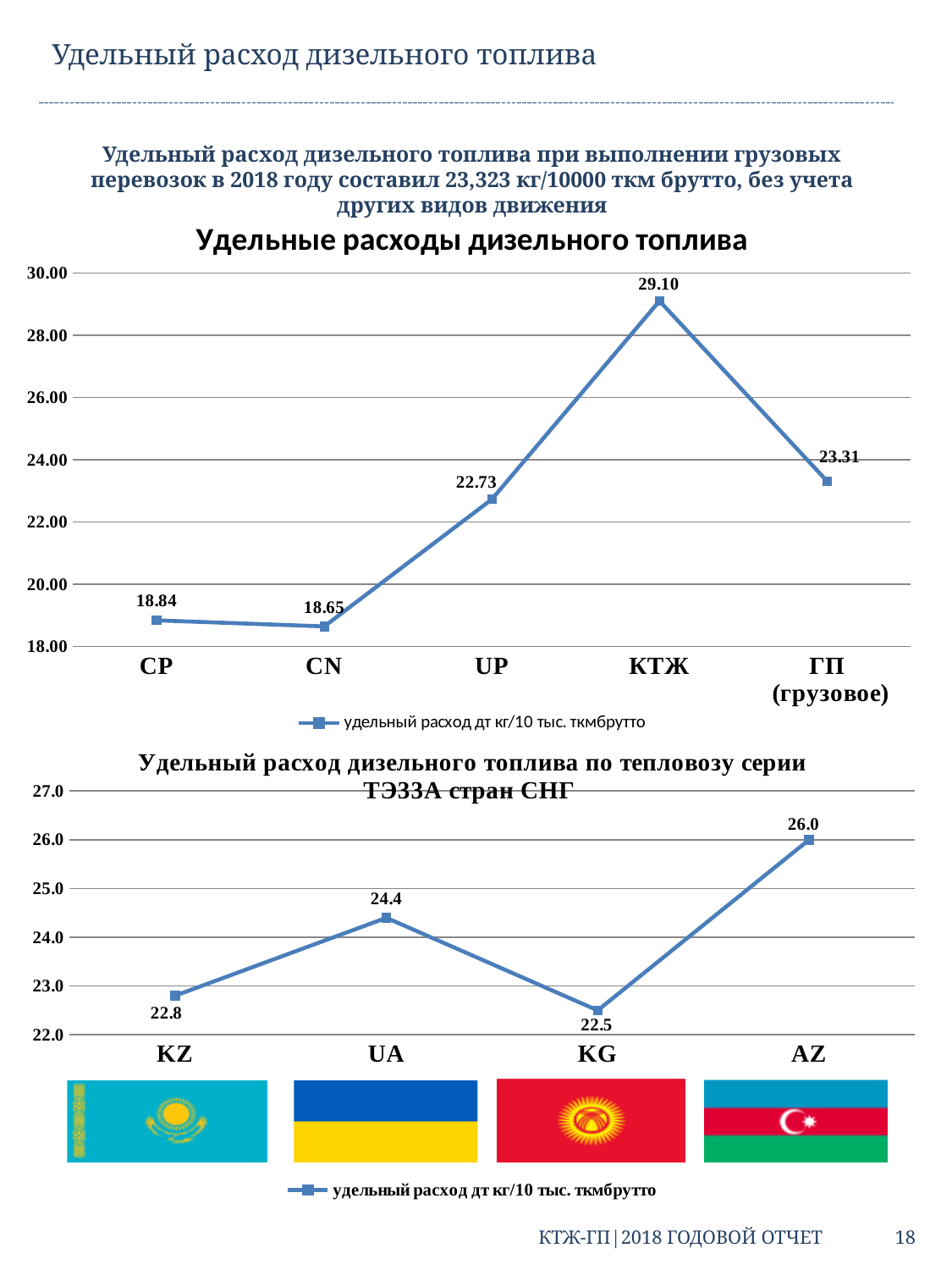
In the top chart 'Удельные расходы дизельного топлива', which category has the highest value? КТЖ In the top chart 'Удельные расходы дизельного топлива', which category has the lowest value? CN In the bottom chart about the ТЭ33А locomotive, which country has the lowest value? KG What type of chart is the top chart 'Удельные расходы дизельного топлива'? line chart In the top chart 'Удельные расходы дизельного топлива', what is the value for КТЖ? 29.10 In the bottom chart about the ТЭ33А locomotive, which country has the highest value? AZ In the top chart 'Удельные расходы дизельного топлива', how many categories are plotted? 5 In the bottom chart about the ТЭ33А locomotive, what is the difference between the values for AZ and KZ? 3.2 In the top chart 'Удельные расходы дизельного топлива', what is the difference between the values for КТЖ and ГП (грузовое)? 5.79 In the bottom chart about the ТЭ33А locomotive, what is the value for UA? 24.4 In the bottom chart about the ТЭ33А locomotive, how many series does the legend list? 1 In the top chart 'Удельные расходы дизельного топлива', what is the value for UP? 22.73